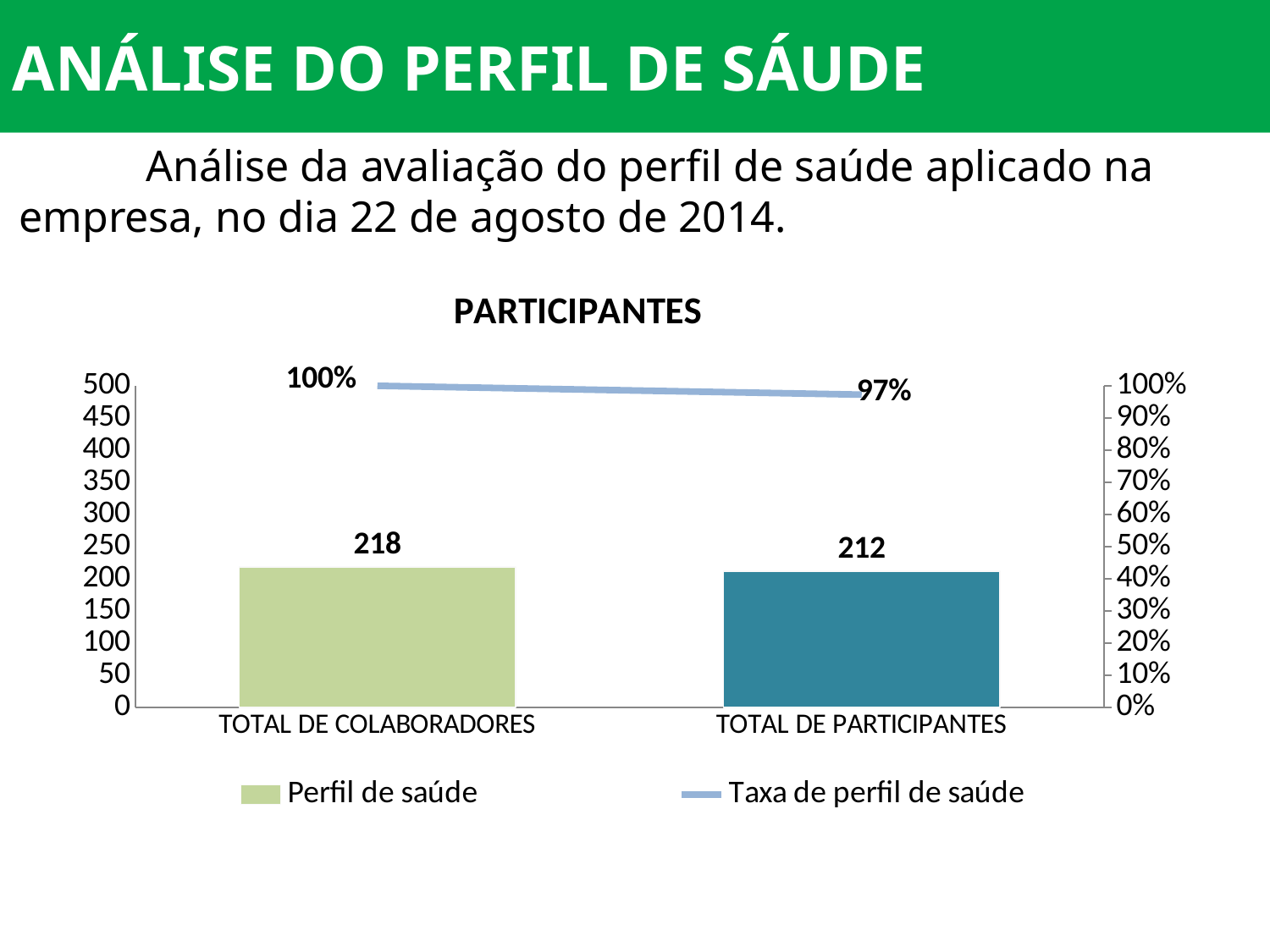
What kind of chart is used for the Perfil de saúde series? bar chart How many categories are shown on the x axis? 2 Is the Perfil de saúde value for TOTAL DE PARTICIPANTES greater or less than 250? less What is the difference between the Perfil de saúde values for TOTAL DE COLABORADORES and TOTAL DE PARTICIPANTES? 6 What is the value of Perfil de saúde for TOTAL DE COLABORADORES? 218 What is the Taxa de perfil de saúde for TOTAL DE PARTICIPANTES? 97% How many series does the legend list? 2 What is the value of Perfil de saúde for TOTAL DE PARTICIPANTES? 212 What is the Taxa de perfil de saúde for TOTAL DE COLABORADORES? 100% What is the title of the chart? PARTICIPANTES Which category has the higher Perfil de saúde value? TOTAL DE COLABORADORES Does the Taxa de perfil de saúde line rise or fall from TOTAL DE COLABORADORES to TOTAL DE PARTICIPANTES? fall